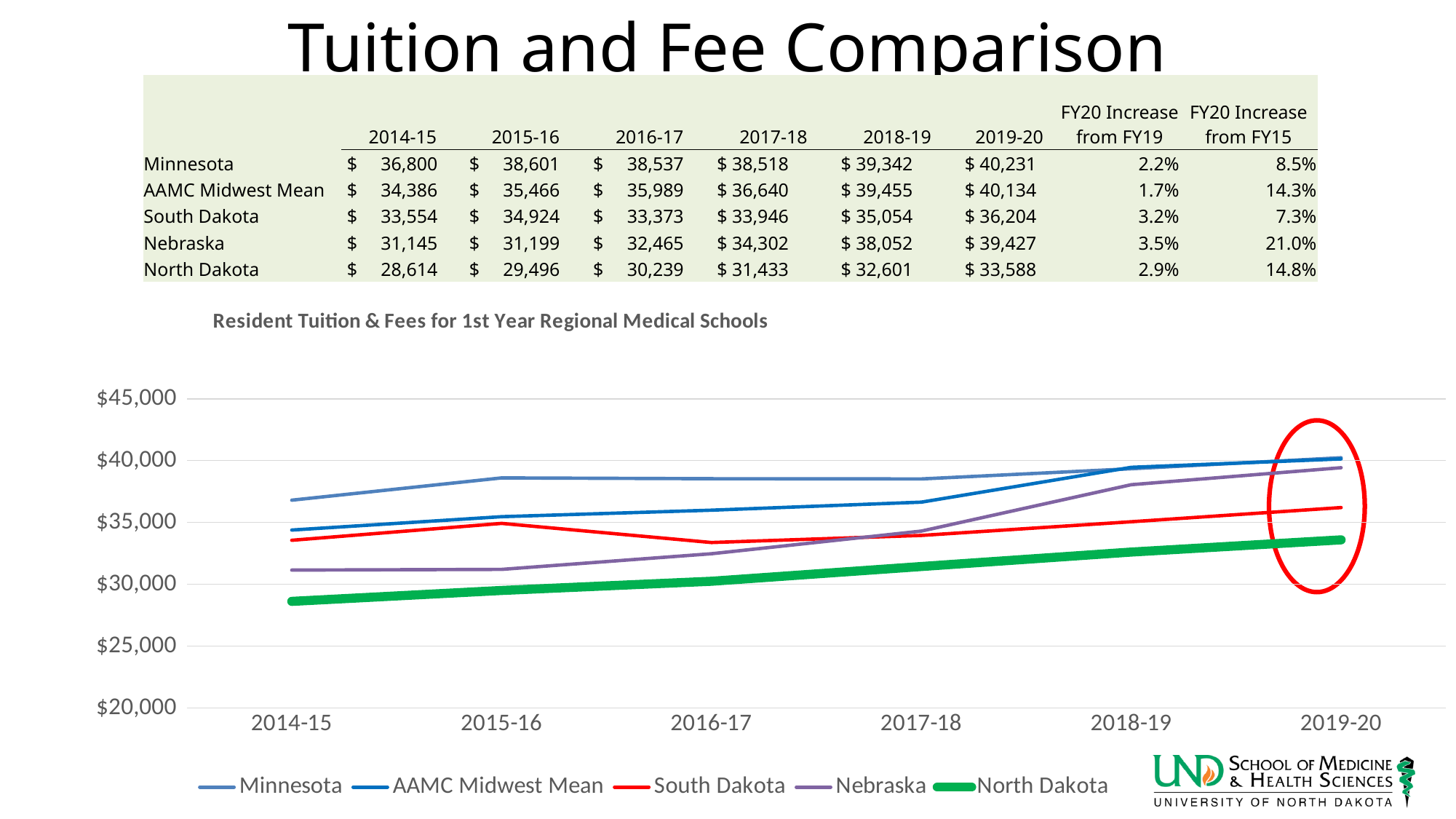
Which series has the lowest value in 2019-20? North Dakota What is the value for North Dakota in 2019-20? $33,588 What kind of chart is shown on the slide? line chart What is the value for South Dakota in 2016-17? $33,373 What is the difference between Minnesota and North Dakota in 2019-20? $6,643 What is the value for Nebraska in 2014-15? $31,145 Which series has the highest value in 2014-15? Minnesota Is the value for North Dakota in 2014-15 greater or less than $30,000? less How many academic years are plotted along the x axis of the chart? 6 Does the North Dakota line rise or fall from 2014-15 to 2019-20? rise In 2019-20, which is larger: South Dakota or Nebraska? Nebraska How many series does the chart legend list? 5